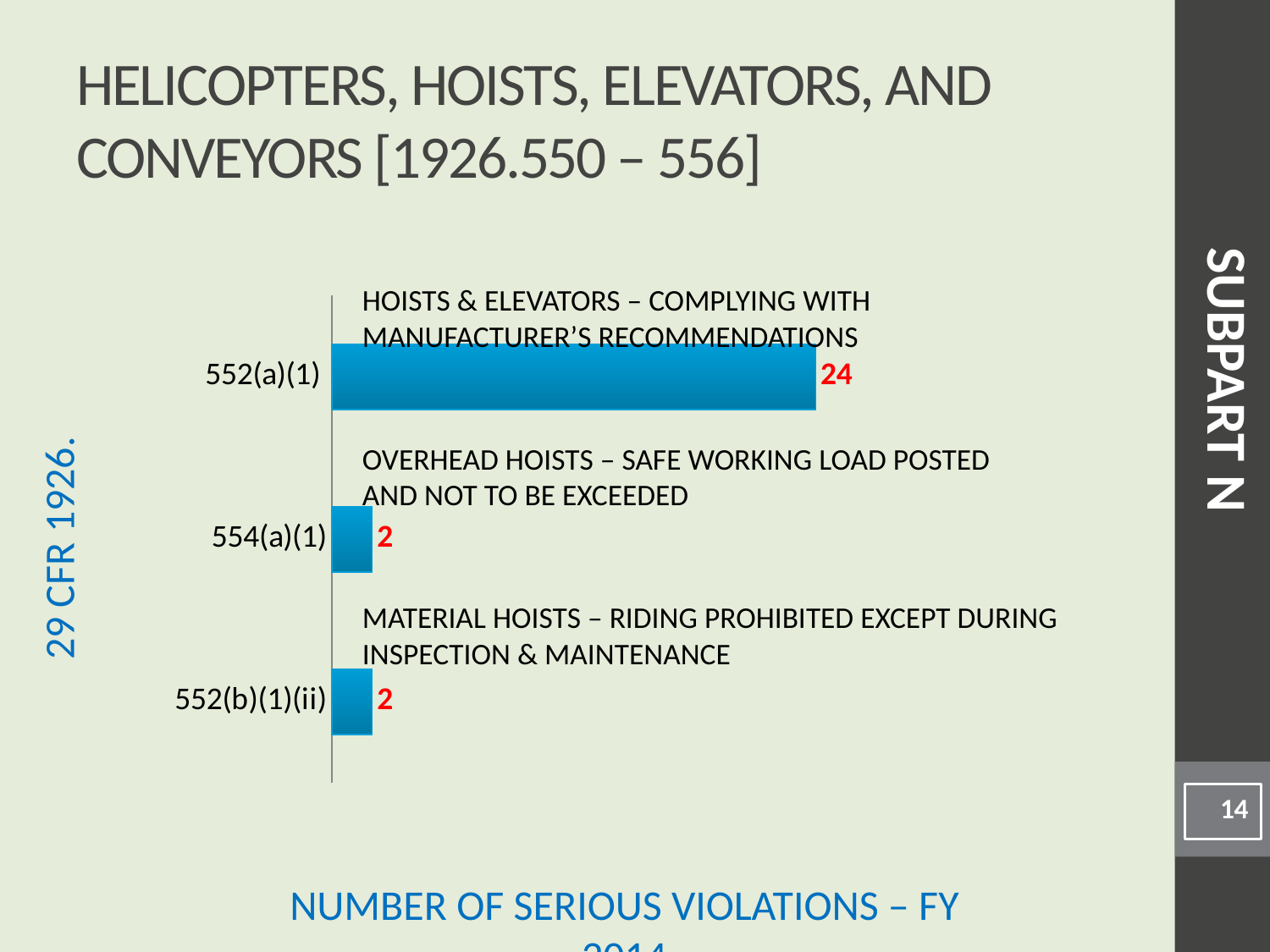
What is the number of serious violations for 552(a)(1)? 24 Which has more serious violations, 552(a)(1) or 552(b)(1)(ii)? 552(a)(1) What kind of chart is shown on the slide? Bar chart What is the difference between the number of serious violations for 552(a)(1) and 554(a)(1)? 22 What is the number of serious violations for 552(b)(1)(ii)? 2 What is the total number of serious violations across all three standards shown? 28 How many standards (categories) are shown in the chart? 3 What is the number of serious violations for 554(a)(1)? 2 What label appears along the vertical axis of the chart? 29 CFR 1926. Which standard has the highest number of serious violations? 552(a)(1) Which standard is described as 'OVERHEAD HOISTS – SAFE WORKING LOAD POSTED AND NOT TO BE EXCEEDED'? 554(a)(1)